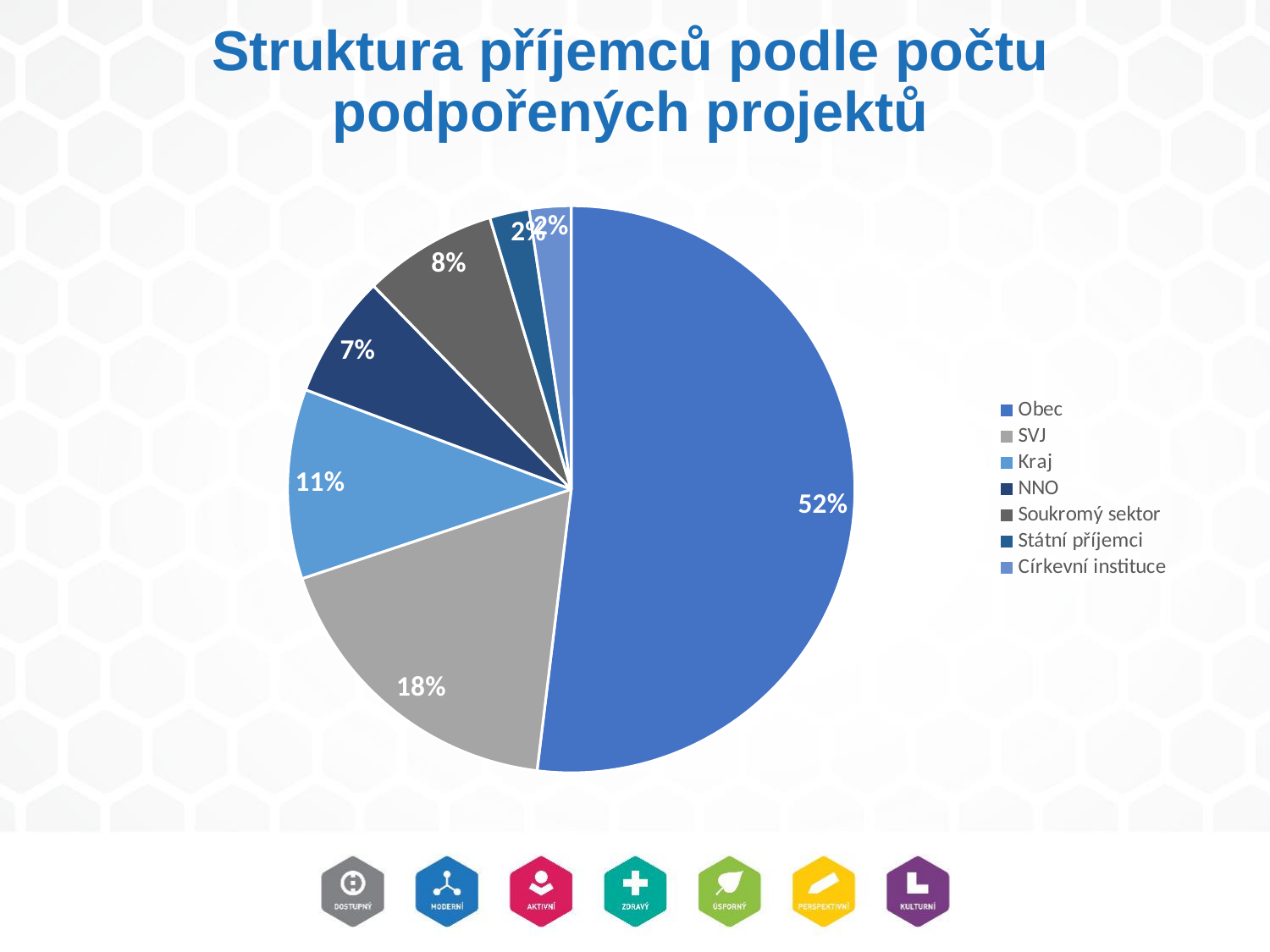
Which category has the largest slice of the pie? Obec How many categories does the legend list? 7 What is the title of the chart? Struktura příjemců podle počtu podpořených projektů What share of the pie does Kraj have? 11% What kind of chart is shown on the slide? pie chart Which legend entry is shown in light grey? SVJ What share of the pie does Obec have? 52% What share of the pie does SVJ have? 18% What is the difference in percentage points between the Obec share and the SVJ share? 34 Which is larger, the share for Kraj or the share for NNO? Kraj